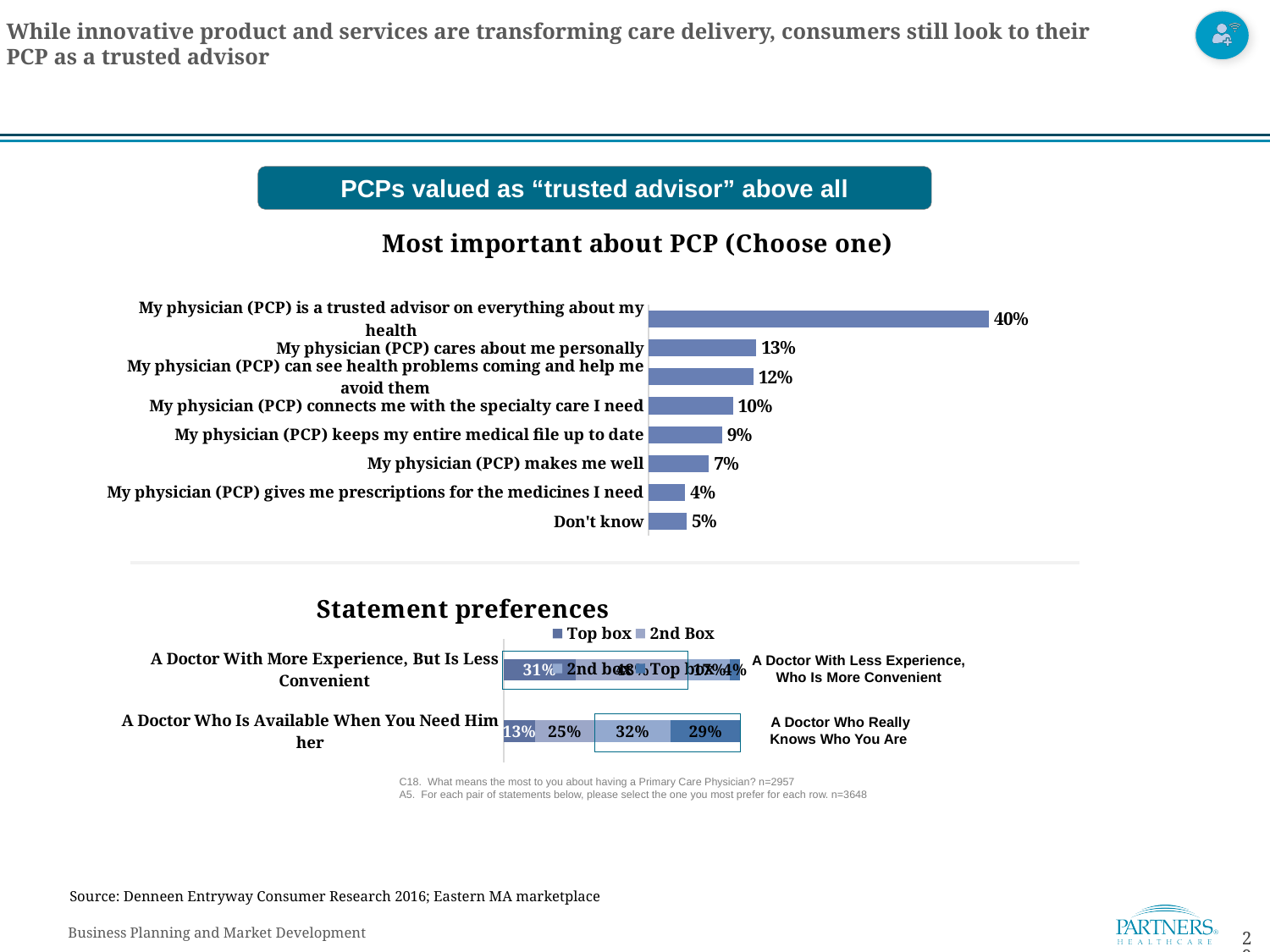
In the 'Most important about PCP (Choose one)' chart, what is the difference between the value for 'trusted advisor on everything about my health' and 'cares about me personally'? 27% In the 'Most important about PCP (Choose one)' chart, what percentage chose 'My physician (PCP) is a trusted advisor on everything about my health'? 40% In the 'Statement preferences' chart, what are the two series named in the legend at the top? Top box and 2nd Box How many categories are shown in the 'Most important about PCP (Choose one)' chart? 8 In the 'Most important about PCP (Choose one)' chart, which category has the highest value? My physician (PCP) is a trusted advisor on everything about my health In the 'Most important about PCP (Choose one)' chart, which is larger: 'My physician (PCP) connects me with the specialty care I need' or 'My physician (PCP) makes me well'? My physician (PCP) connects me with the specialty care I need In the 'Most important about PCP (Choose one)' chart, what is the value for 'My physician (PCP) keeps my entire medical file up to date'? 9% What type of chart is the 'Most important about PCP (Choose one)' chart? Bar chart In the 'Most important about PCP (Choose one)' chart, which category has the lowest value? My physician (PCP) gives me prescriptions for the medicines I need In the 'Most important about PCP (Choose one)' chart, what is the value for 'Don't know'? 5% In the 'Most important about PCP (Choose one)' chart, what is the value for 'My physician (PCP) cares about me personally'? 13% In the 'Statement preferences' chart, what is the largest segment value shown in the bar for 'A Doctor Who Is Available When You Need Him her' versus 'A Doctor Who Really Knows Who You Are'? 32%